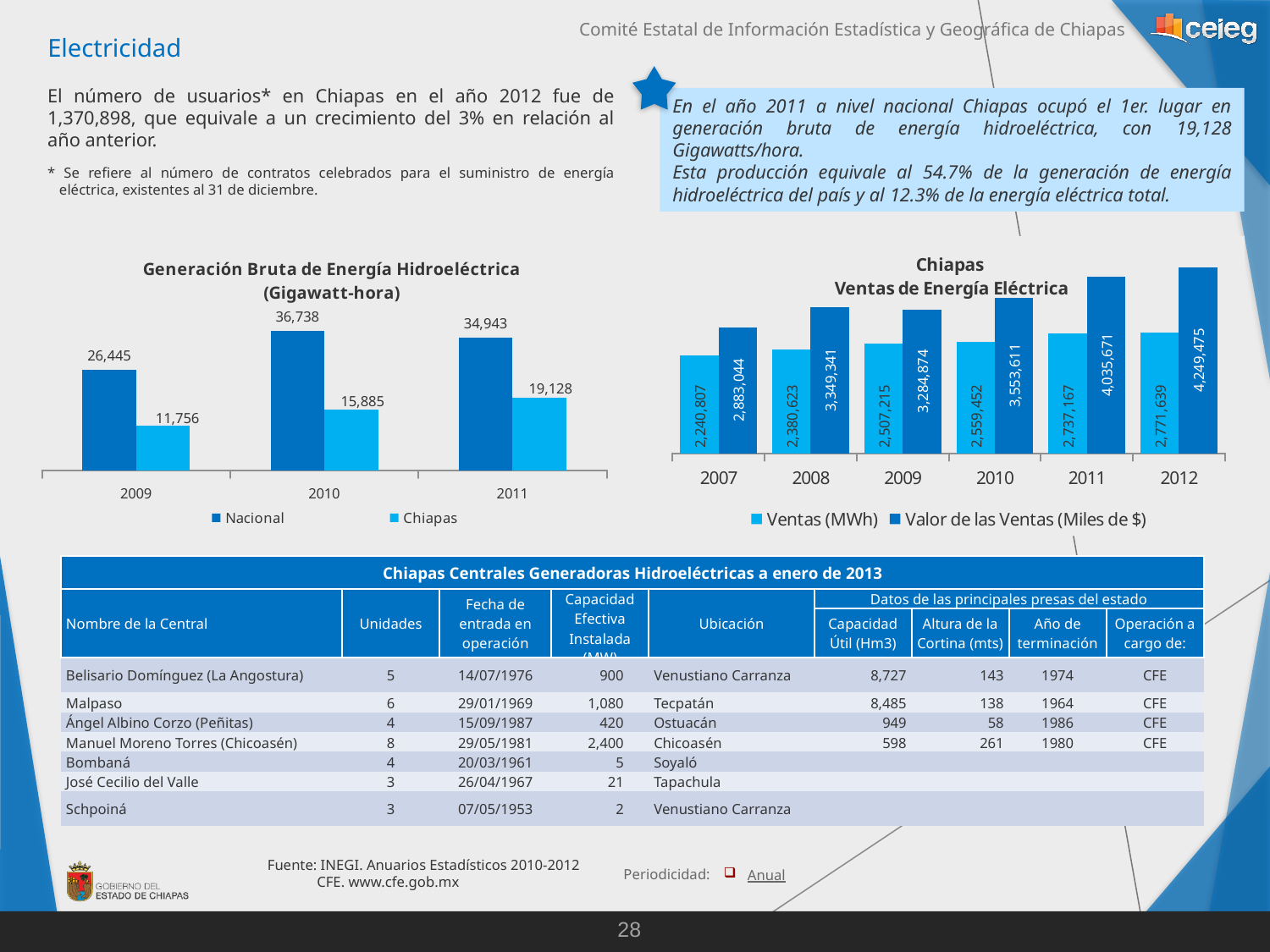
In the 'Generación Bruta de Energía Hidroeléctrica' chart, what is the difference between the Nacional and Chiapas values for 2009? 14,689 In the 'Generación Bruta de Energía Hidroeléctrica' chart, which year has the highest Nacional value? 2010 In the 'Chiapas Ventas de Energía Eléctrica' chart, what is the Valor de las Ventas (Miles de $) value for 2008? 3,349,341 In the 'Generación Bruta de Energía Hidroeléctrica' chart, what is the Nacional value for 2010? 36,738 In the 'Chiapas Ventas de Energía Eléctrica' chart, what is the Ventas (MWh) value for 2012? 2,771,639 In the 'Generación Bruta de Energía Hidroeléctrica' chart, what is the Chiapas value for 2011? 19,128 In the 'Generación Bruta de Energía Hidroeléctrica' chart, which year has the lowest Chiapas value? 2009 In the 'Chiapas Ventas de Energía Eléctrica' chart, which is larger: Valor de las Ventas in 2009 or in 2010? 2010 In the 'Generación Bruta de Energía Hidroeléctrica' chart, how many series does the legend list? 2 In the 'Chiapas Ventas de Energía Eléctrica' chart, how many years are shown on the x axis? 6 In the 'Chiapas Ventas de Energía Eléctrica' chart, do the Ventas (MWh) values rise or fall from 2007 to 2012? rise What kind of chart is the 'Chiapas Ventas de Energía Eléctrica' chart? bar chart